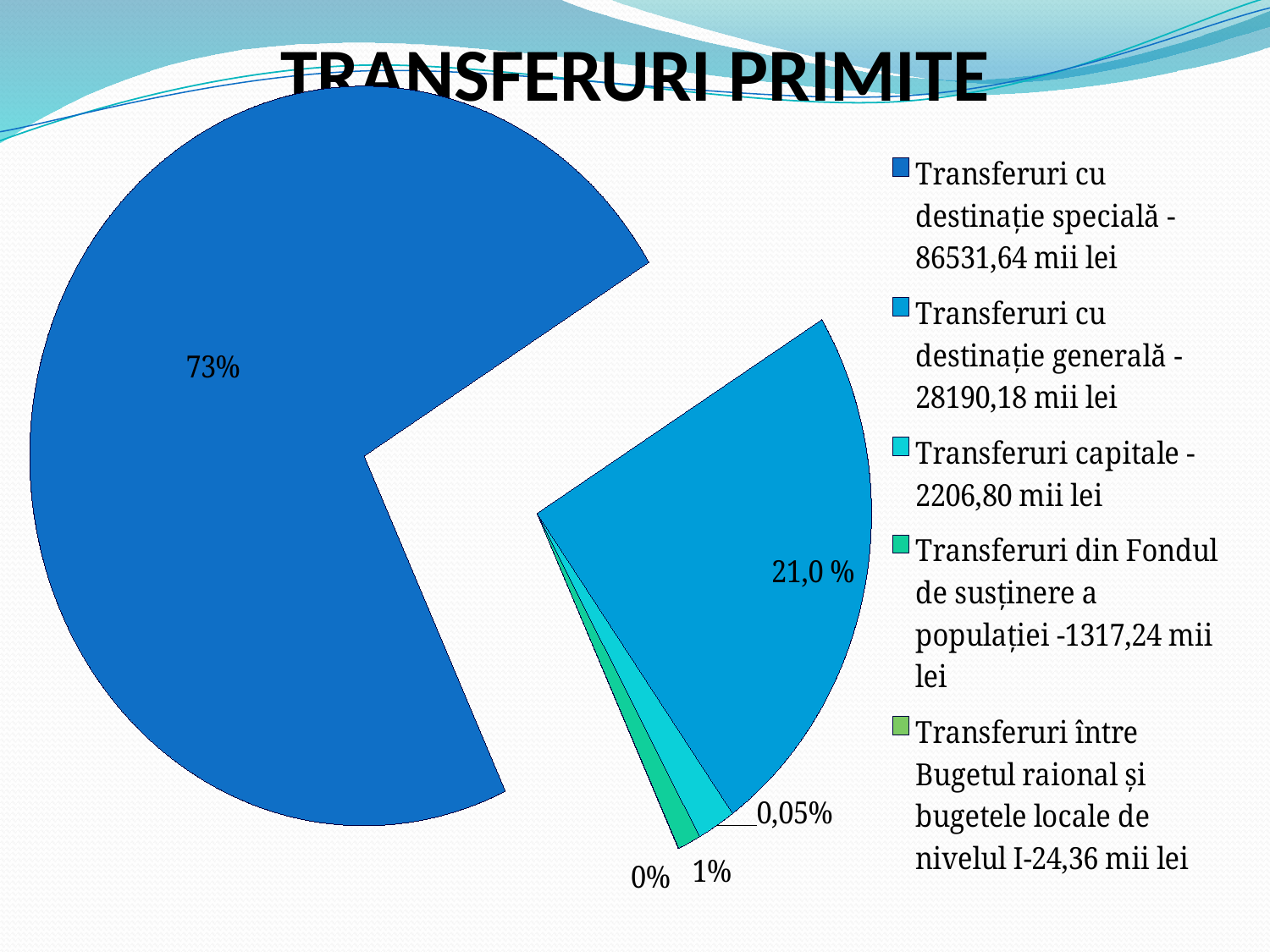
What kind of chart is shown on the slide? pie chart What amount in mii lei is given in the legend for 'Transferuri din Fondul de susținere a populației'? 1317,24 mii lei Which category has the smallest slice of the pie? Transferuri între Bugetul raional și bugetele locale de nivelul I What share of the pie does 'Transferuri cu destinație generală' represent? 21,0 % What share of the pie does 'Transferuri cu destinație specială' represent? 73% How many entries does the legend list? 5 What is the title of the chart? TRANSFERURI PRIMITE Which category has the largest slice of the pie? Transferuri cu destinație specială Which is larger: 'Transferuri cu destinație generală' or 'Transferuri capitale'? Transferuri cu destinație generală What amount in mii lei is given in the legend for 'Transferuri capitale'? 2206,80 mii lei What is the difference in mii lei between 'Transferuri cu destinație specială' (86531,64) and 'Transferuri cu destinație generală' (28190,18)? 58341,46 mii lei How many slices does the pie chart have? 5